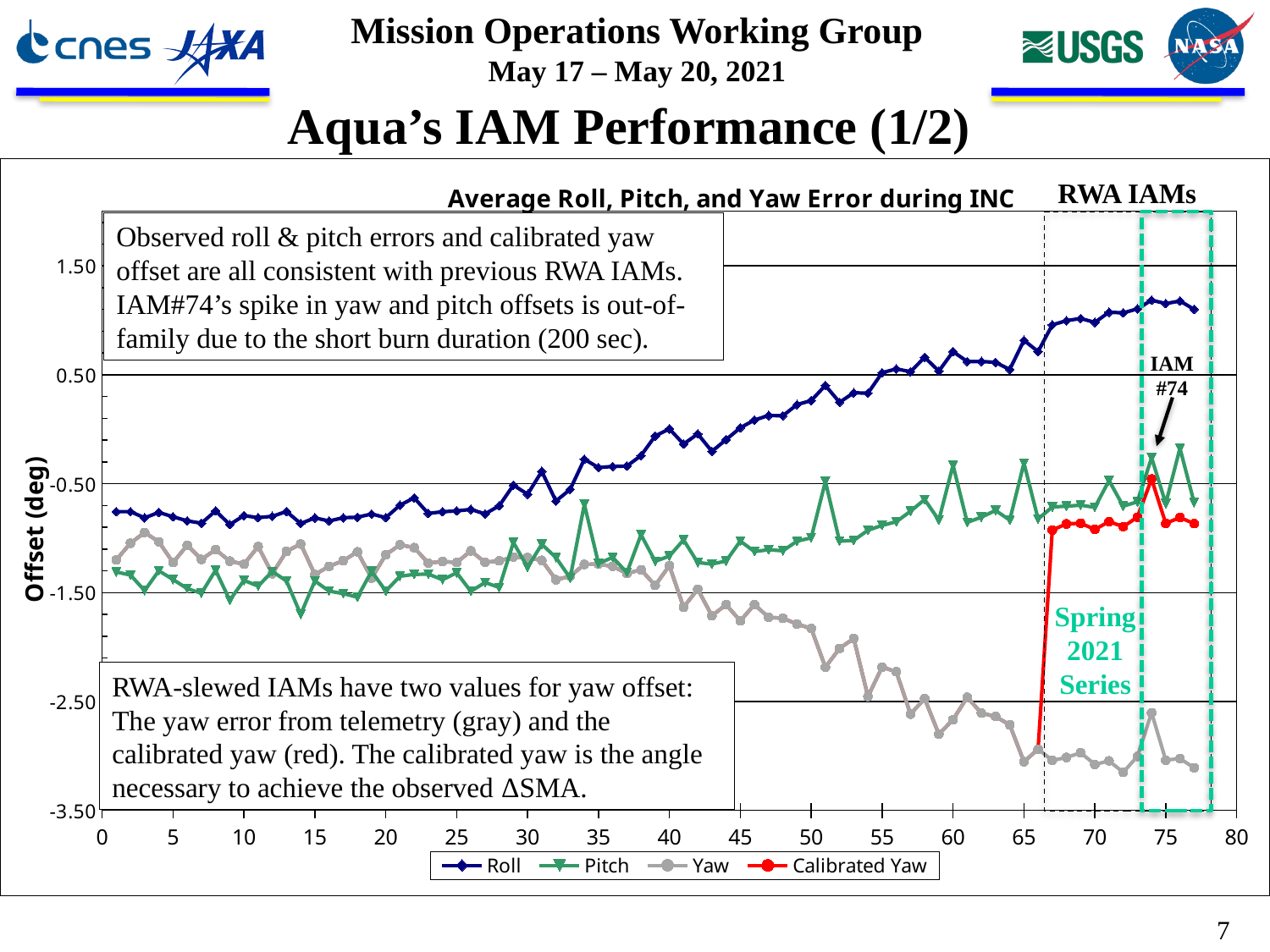
What type of chart is shown on the slide? line chart What is the label of the vertical axis of the chart? Offset (deg) Which series has the lowest values at the right end of the chart (around x = 75)? Yaw How many series does the chart legend list? 4 What is the title of the chart? Average Roll, Pitch, and Yaw Error during INC Is the Pitch value at x = 1 greater or less than -0.50? less Does the Roll series generally rise or fall as the x-axis value increases? rise Is the Roll value at x = 70 greater or less than 0.50? greater Is the Yaw value at x = 65 greater or less than -2.50? less Does the Yaw series generally rise or fall as the x-axis value increases? fall At x = 70, which series has the larger value, Roll or Yaw? Roll